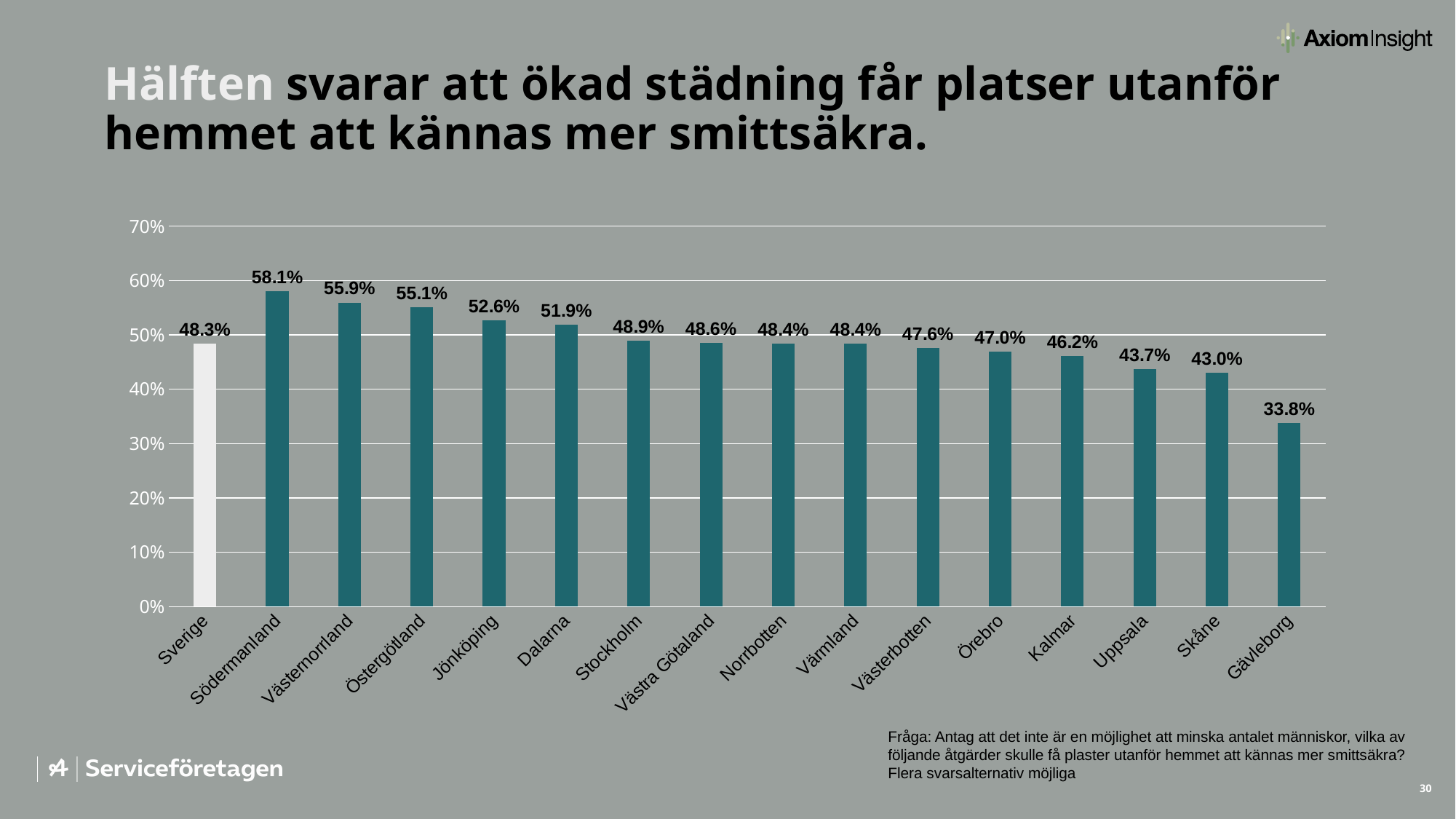
What is the difference between the values for Västernorrland and Östergötland? 0.8% What kind of chart is shown on the slide? bar chart Which bar is shown in a different colour (light grey) from the others? Sverige Which category has the highest value? Södermanland What is the value for Sverige? 48.3% Which is larger, the value for Jönköping or the value for Kalmar? Jönköping Which category has the lowest value? Gävleborg How many categories are shown on the x axis? 16 What is the value for Stockholm? 48.9% What is the difference between the values for Södermanland and Gävleborg? 24.3% Is the value for Uppsala greater or less than 50%? less What is the value for Gävleborg? 33.8%